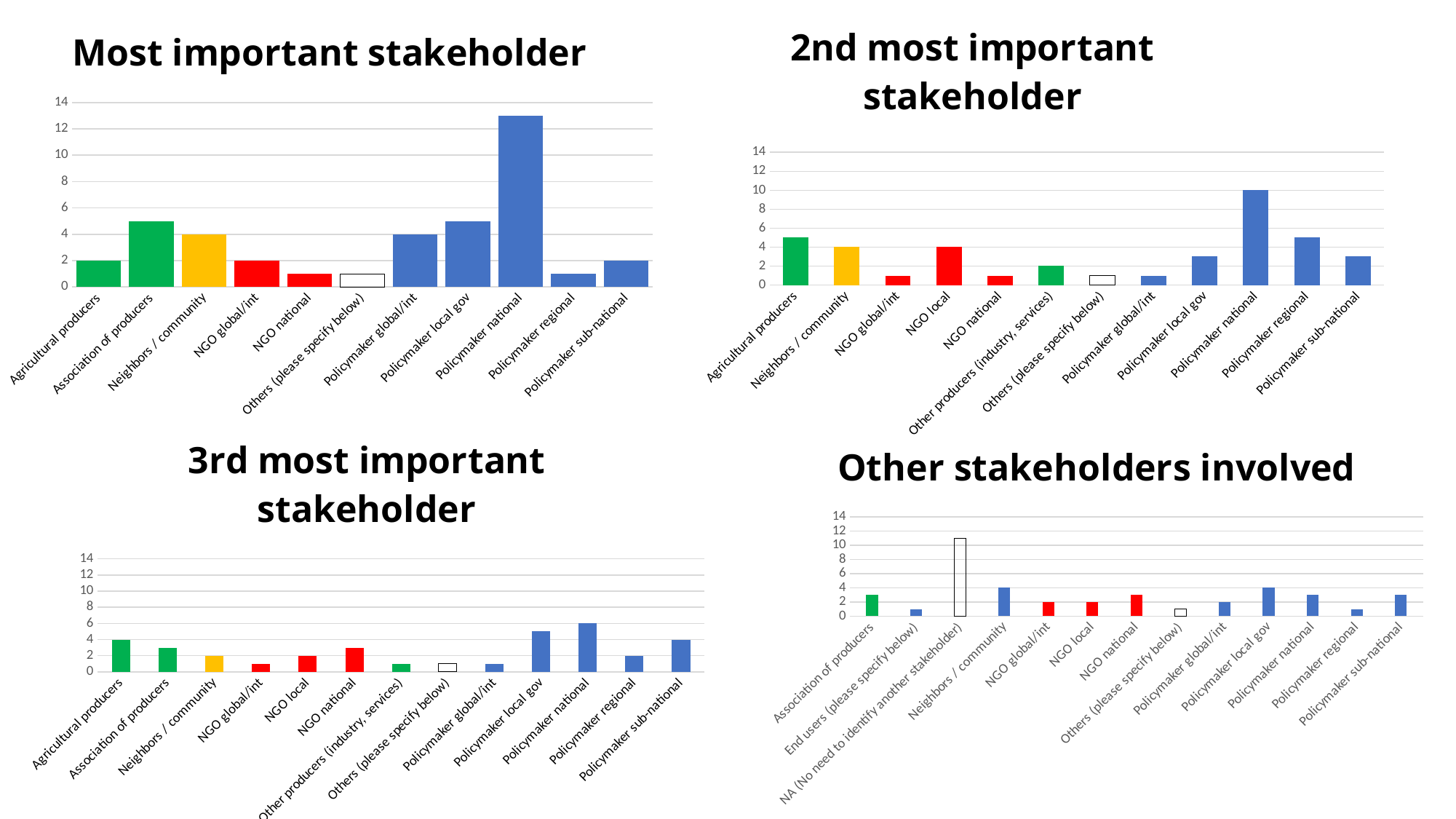
In the '2nd most important stakeholder' chart, which category has the highest bar? Policymaker national In the '3rd most important stakeholder' chart, which is larger, Agricultural producers or Neighbors / community? Agricultural producers How many charts are shown on the slide, and what type are they? 4 bar charts In the 'Most important stakeholder' chart, what is the value for Agricultural producers? 2 In the 'Most important stakeholder' chart, is the value for Policymaker national greater or less than 12? greater In the 'Most important stakeholder' chart, which category has the highest bar? Policymaker national In the 'Other stakeholders involved' chart, which category has the highest bar? NA (No need to identify another stakeholder) In the 'Most important stakeholder' chart, what is the value for Neighbors / community? 4 In the 'Other stakeholders involved' chart, is the value for NA (No need to identify another stakeholder) greater or less than 10? greater In the '2nd most important stakeholder' chart, what is the value for NGO local? 4 In the '2nd most important stakeholder' chart, what is the value for Policymaker national? 10 In the '3rd most important stakeholder' chart, what is the value for Policymaker national? 6